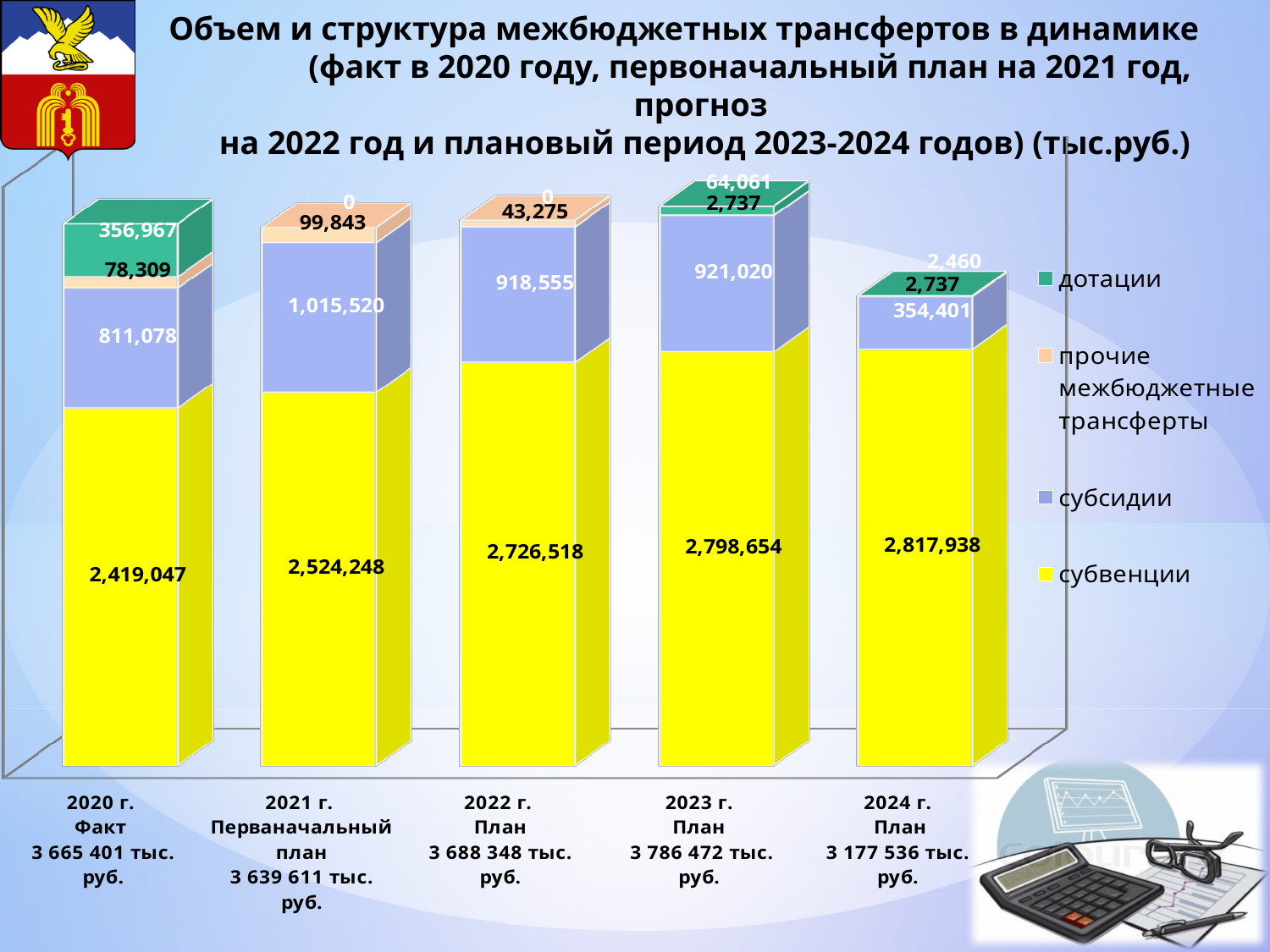
Which is larger: субсидии in 2022 г. План or субсидии in 2023 г. План? 2023 г. План What is the difference between субвенции in 2024 г. План and 2020 г. Факт? 398,891 What is the value of субвенции for 2020 г. Факт? 2,419,047 What is the value of субсидии for 2021 г. Первоначальный план? 1,015,520 What is the value of дотации for 2023 г. План? 64,061 How many years (categories) are shown on the x axis? 5 What kind of chart is shown on the slide? Stacked bar chart What is the value of прочие межбюджетные трансферты for 2022 г. План? 43,275 Do the values of субвенции rise or fall from 2020 to 2024? Rise Which year has the highest value of субвенции? 2024 г. План How many series does the legend list? 4 Which year has the lowest value of субсидии? 2024 г. План